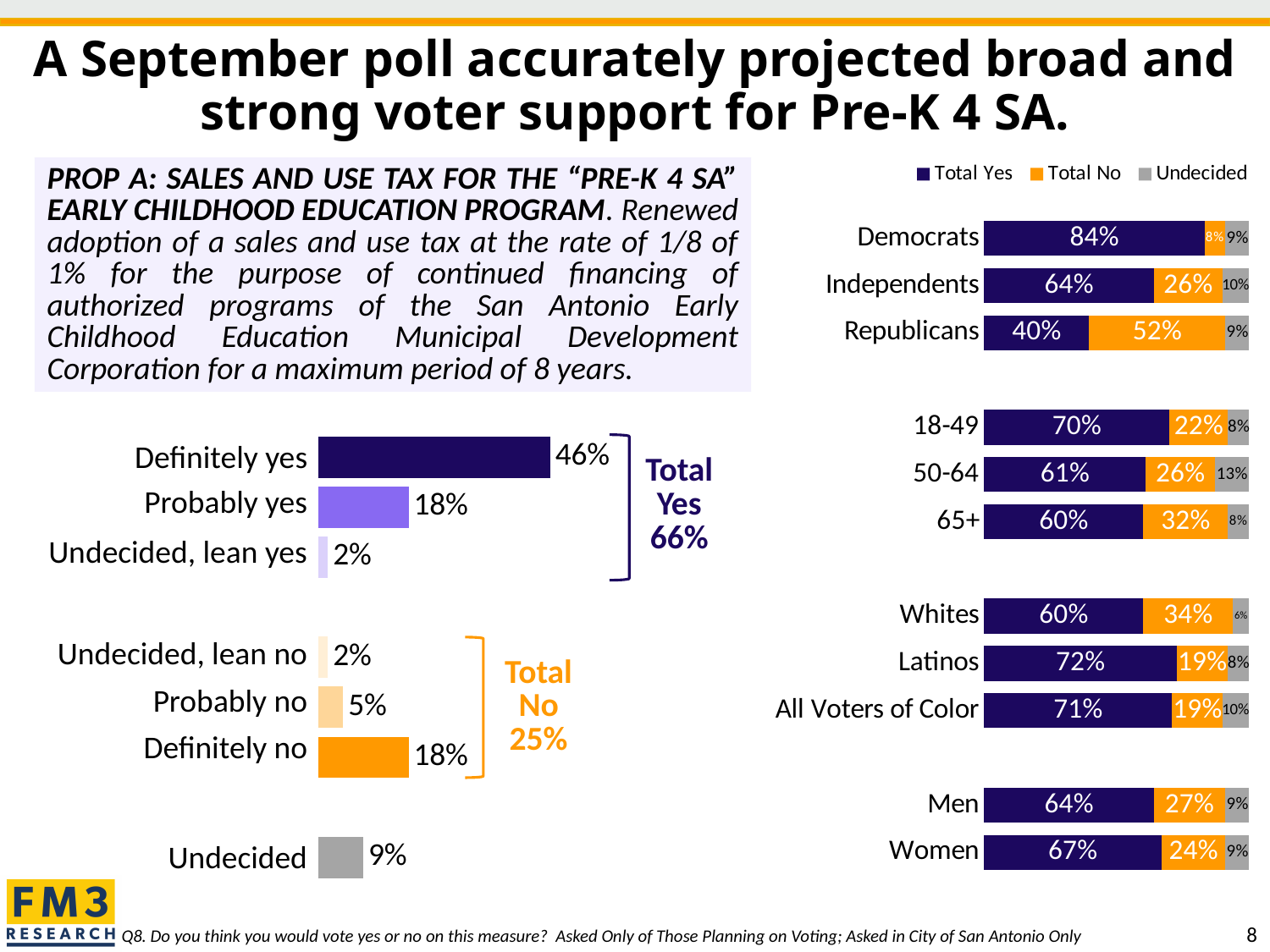
In the right stacked bar chart, what is the Total No value for Republicans? 52% In the left bar chart, what percentage of respondents said "Definitely yes"? 46% In the left bar chart, what is the difference between "Definitely yes" and "Definitely no"? 28% In the left bar chart, what percentage of respondents said "Probably no"? 5% In the left bar chart, which response category has the highest value? Definitely yes In the right stacked bar chart, what is the Total Yes value for Democrats? 84% How many series does the legend of the right stacked bar chart list? 3 In the left bar chart, how many response categories are plotted? 7 In the right stacked bar chart, what is the Undecided value for the 50-64 age group? 13% In the right stacked bar chart, which group has the lowest Total Yes value? Republicans In the right stacked bar chart, is the Total Yes value larger for Men or for Women? Women What kind of chart is the chart on the right side of the slide? Stacked bar chart